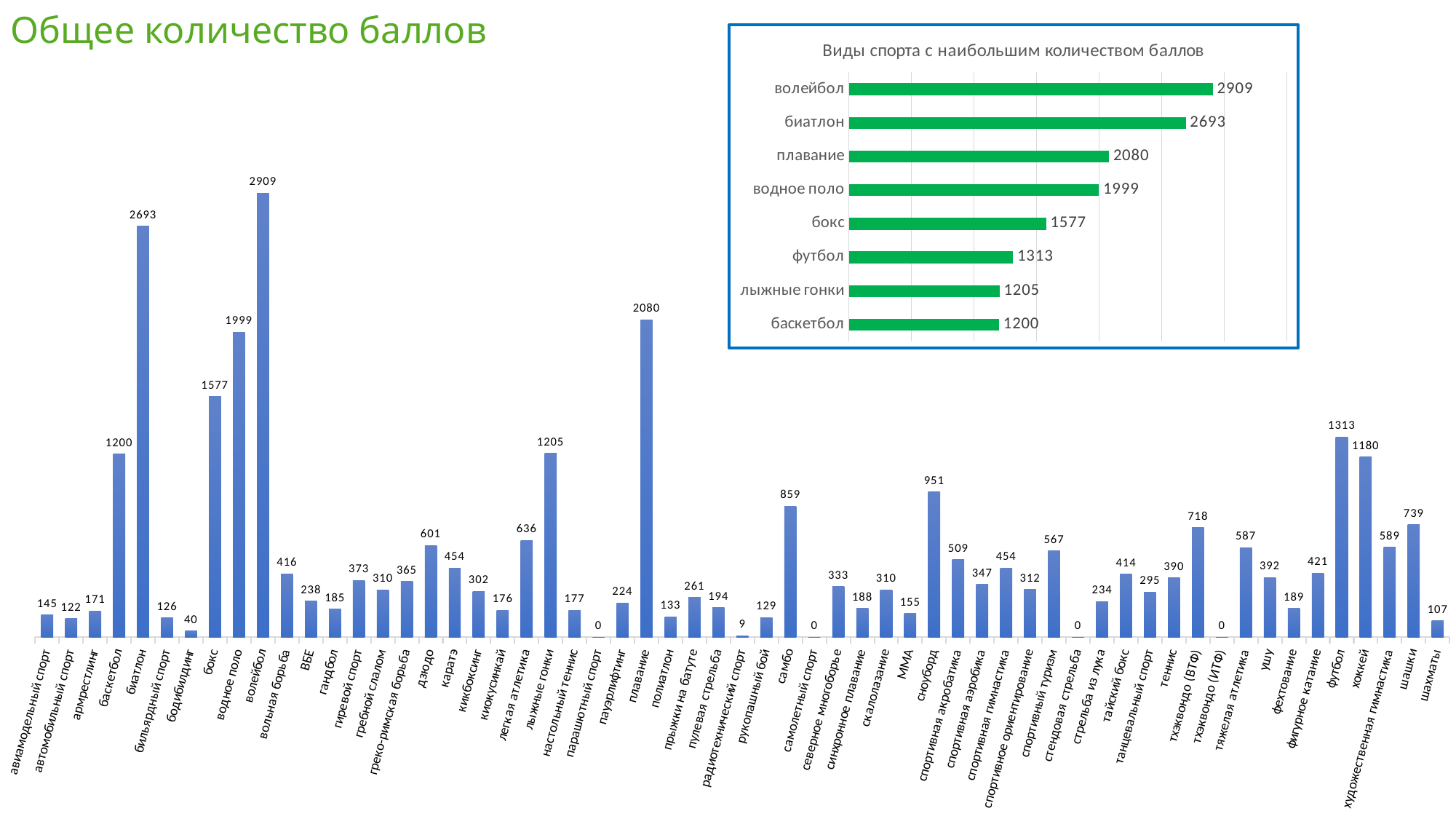
In the inset chart 'Виды спорта с наибольшим количеством баллов', how many sports are listed? 8 In the large chart on the left, which sport has the highest value? волейбол In the inset chart 'Виды спорта с наибольшим количеством баллов', which sport has the lowest value? баскетбол In the large chart on the left, what is the value for шашки? 739 What kind of chart is the inset chart 'Виды спорта с наибольшим количеством баллов'? Bar chart In the inset chart 'Виды спорта с наибольшим количеством баллов', what is the value for биатлон? 2693 In the inset chart 'Виды спорта с наибольшим количеством баллов', which sport has the highest value? волейбол In the large chart on the left, which is larger: сноуборд or спортивный туризм? сноуборд In the large chart on the left, what is the value for хоккей? 1180 In the large chart on the left, what is the difference between футбол and хоккей? 133 In the inset chart 'Виды спорта с наибольшим количеством баллов', what is the difference between волейбол and биатлон? 216 In the large chart on the left, what is the value for самбо? 859